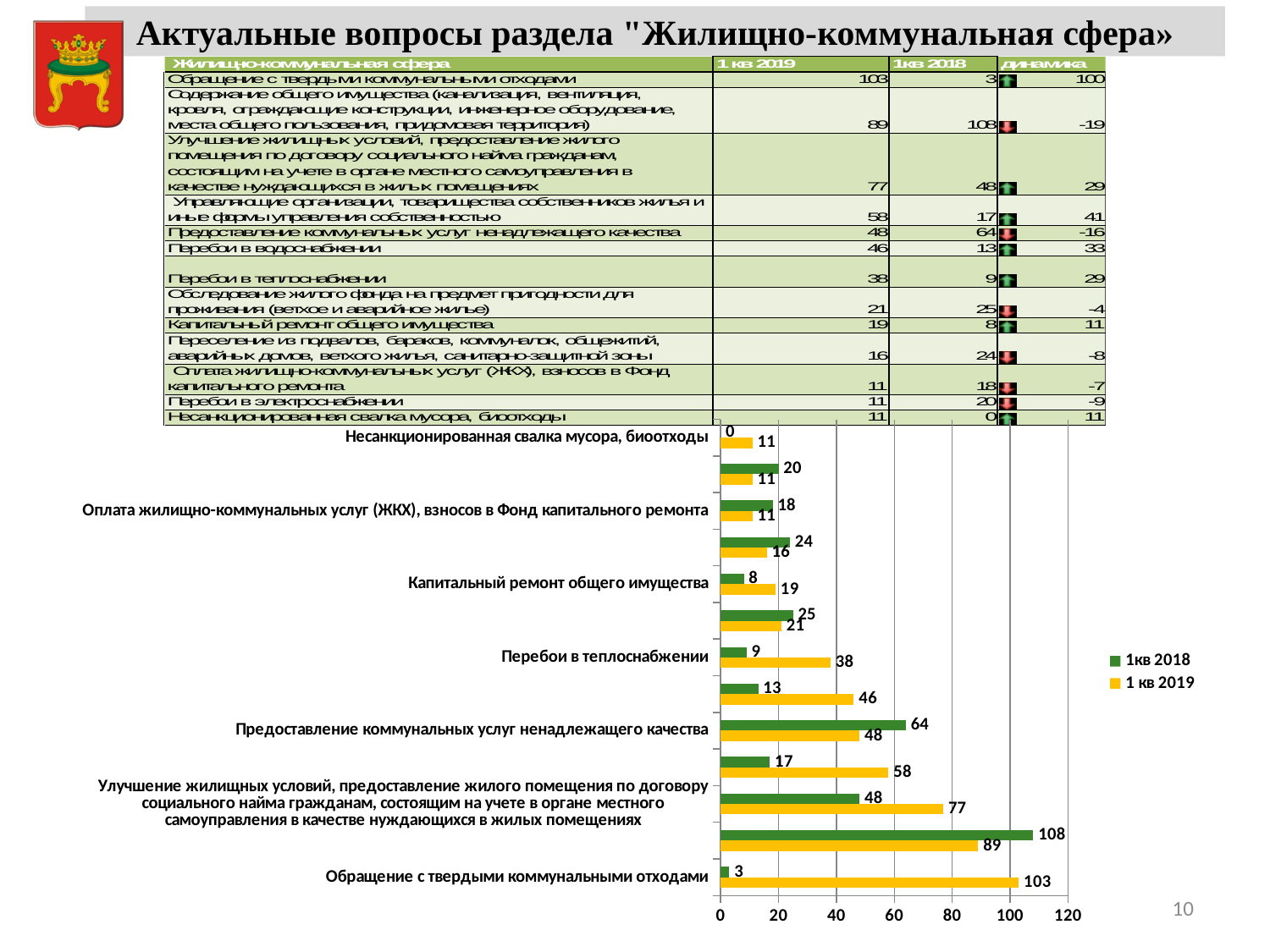
Which colour represents the 1 кв 2019 series in the chart? yellow How many series does the chart legend list? 2 What is the value for 1 кв 2019 for "Обращение с твердыми коммунальными отходами"? 103 For "Предоставление коммунальных услуг ненадлежащего качества", which is larger: the 1кв 2018 value or the 1 кв 2019 value? 1кв 2018 What is the value for 1кв 2018 for "Обращение с твердыми коммунальными отходами"? 3 Which labelled category has the highest value for 1 кв 2019? Обращение с твердыми коммунальными отходами What is the value for 1кв 2018 for "Предоставление коммунальных услуг ненадлежащего качества"? 64 What is the difference between the 1 кв 2019 and 1кв 2018 values for "Обращение с твердыми коммунальными отходами"? 100 What is the value for 1 кв 2019 for "Перебои в теплоснабжении"? 38 What is the difference between the 1 кв 2019 and 1кв 2018 values for "Улучшение жилищных условий, предоставление жилого помещения по договору социального найма..."? 29 What kind of chart is shown on the slide? bar chart What is the value for 1 кв 2019 for "Капитальный ремонт общего имущества"? 19